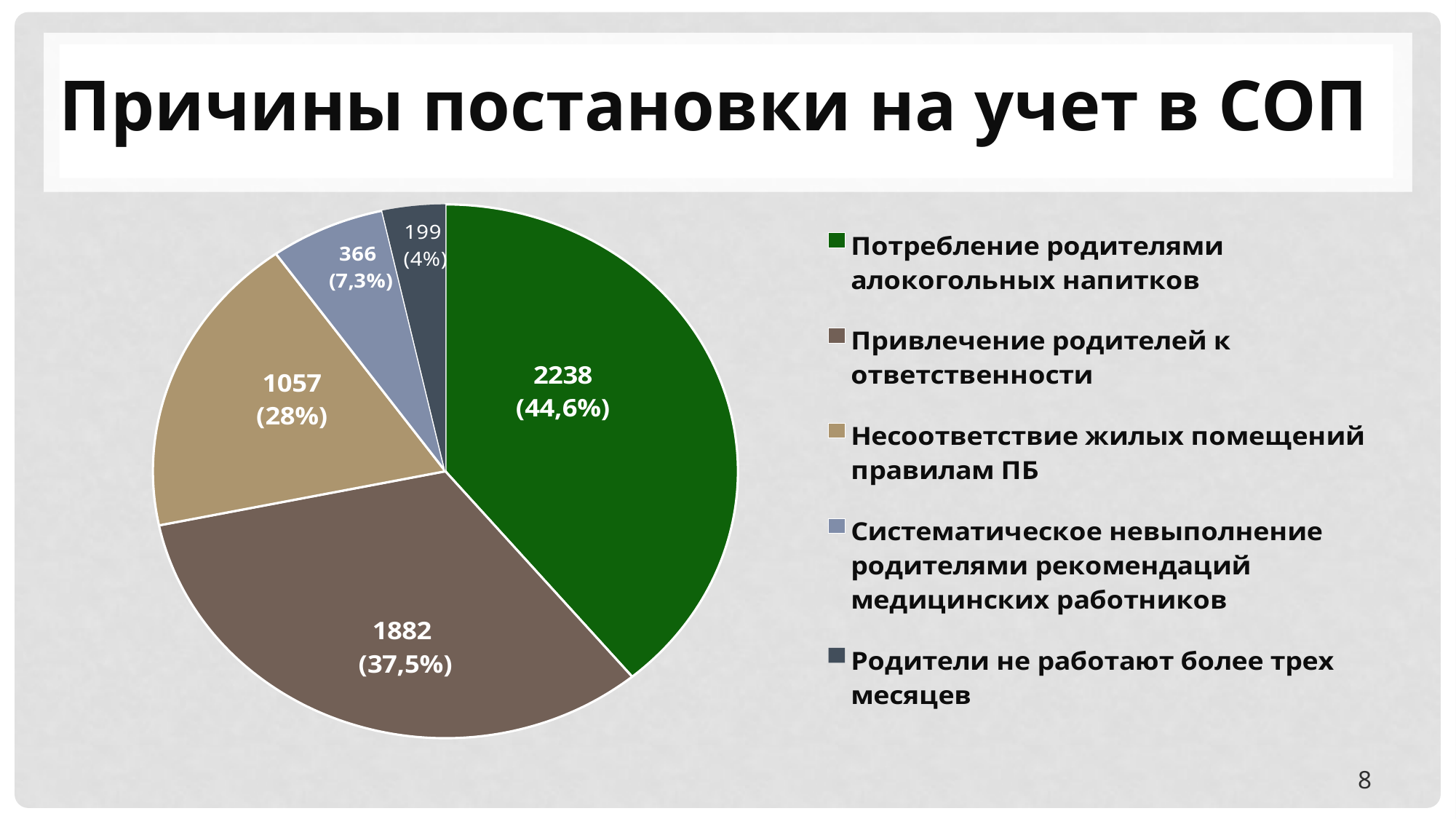
Какая доля в процентах указана для категории «Потребление родителями алокогольных напитков»? 44,6% Какая доля в процентах указана для категории «Систематическое невыполнение родителями рекомендаций медицинских работников»? 7,3% На сколько значение категории «Потребление родителями алокогольных напитков» больше значения категории «Привлечение родителей к ответственности»? 356 Какая категория имеет наибольшее значение? Потребление родителями алокогольных напитков Какое значение указано для категории «Родители не работают более трех месяцев»? 199 Сколько категорий (секторов) показано на круговой диаграмме? 5 Какая категория имеет наименьшее значение? Родители не работают более трех месяцев Какой тип диаграммы показан на слайде? Круговая диаграмма Какое значение указано для категории «Несоответствие жилых помещений правилам ПБ»? 1057 Какое значение указано для категории «Привлечение родителей к ответственности»? 1882 Какая категория больше: «Несоответствие жилых помещений правилам ПБ» или «Систематическое невыполнение родителями рекомендаций медицинских работников»? Несоответствие жилых помещений правилам ПБ Какое значение указано для категории «Потребление родителями алокогольных напитков»? 2238